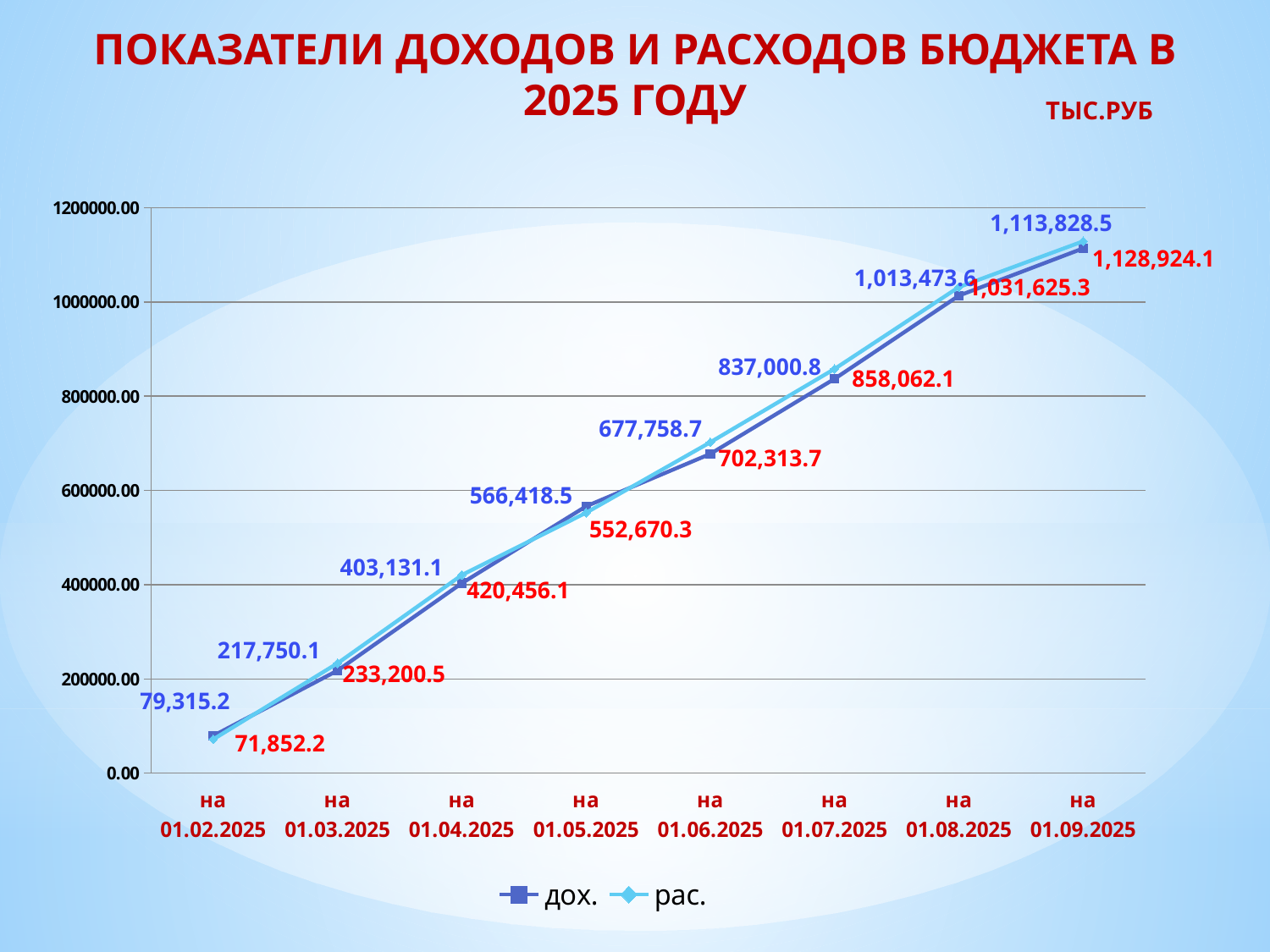
What is the value of рас. on 01.07.2025? 858,062.1 How many series does the legend list? 2 What is the value of рас. on 01.09.2025? 1,128,924.1 Which is larger on 01.08.2025, дох. or рас.? рас. How many dates are plotted on the x axis? 8 What is the difference between рас. and дох. on 01.06.2025? 24,555.0 What is the value of дох. on 01.02.2025? 79,315.2 What kind of chart is shown on the slide? line chart What is the difference between рас. and дох. on 01.09.2025? 15,095.6 What is the value of дох. on 01.05.2025? 566,418.5 On which date is the value of рас. lowest? на 01.02.2025 On which date is the value of дох. highest? на 01.09.2025